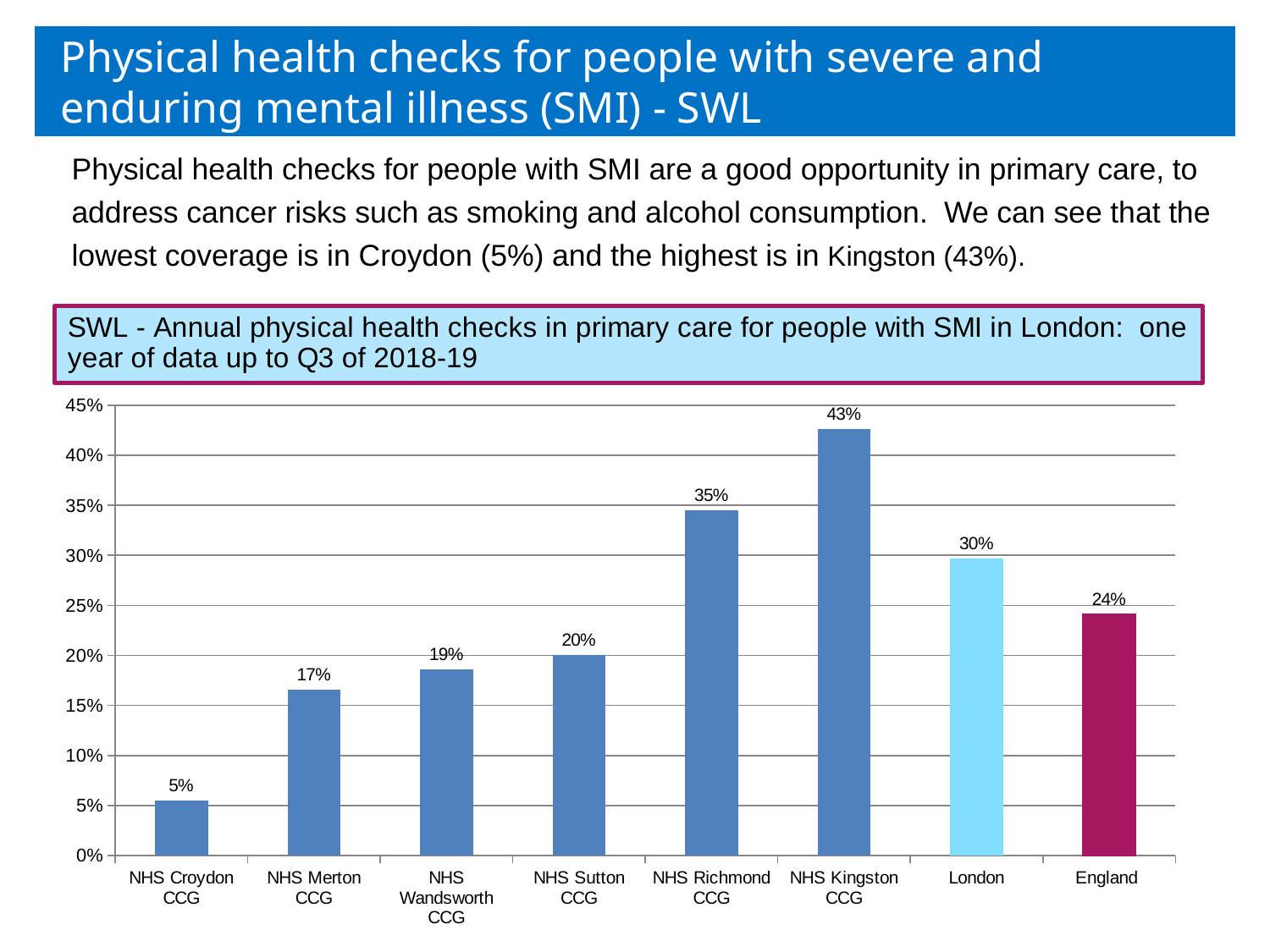
Which is larger, the value for NHS Sutton CCG or NHS Wandsworth CCG? NHS Sutton CCG What kind of chart is shown on the slide? Bar chart What is the value for NHS Croydon CCG? 5% What is the difference between the values for NHS Kingston CCG and NHS Croydon CCG? 38% What is the value for London? 30% What is the value for England? 24% What is the value for NHS Richmond CCG? 35% How many bars are shown in the chart? 8 Is the value for NHS Merton CCG greater or less than 20%? less Which category has the lowest value? NHS Croydon CCG What is the difference between the values for London and England? 6% Which category has the highest value? NHS Kingston CCG